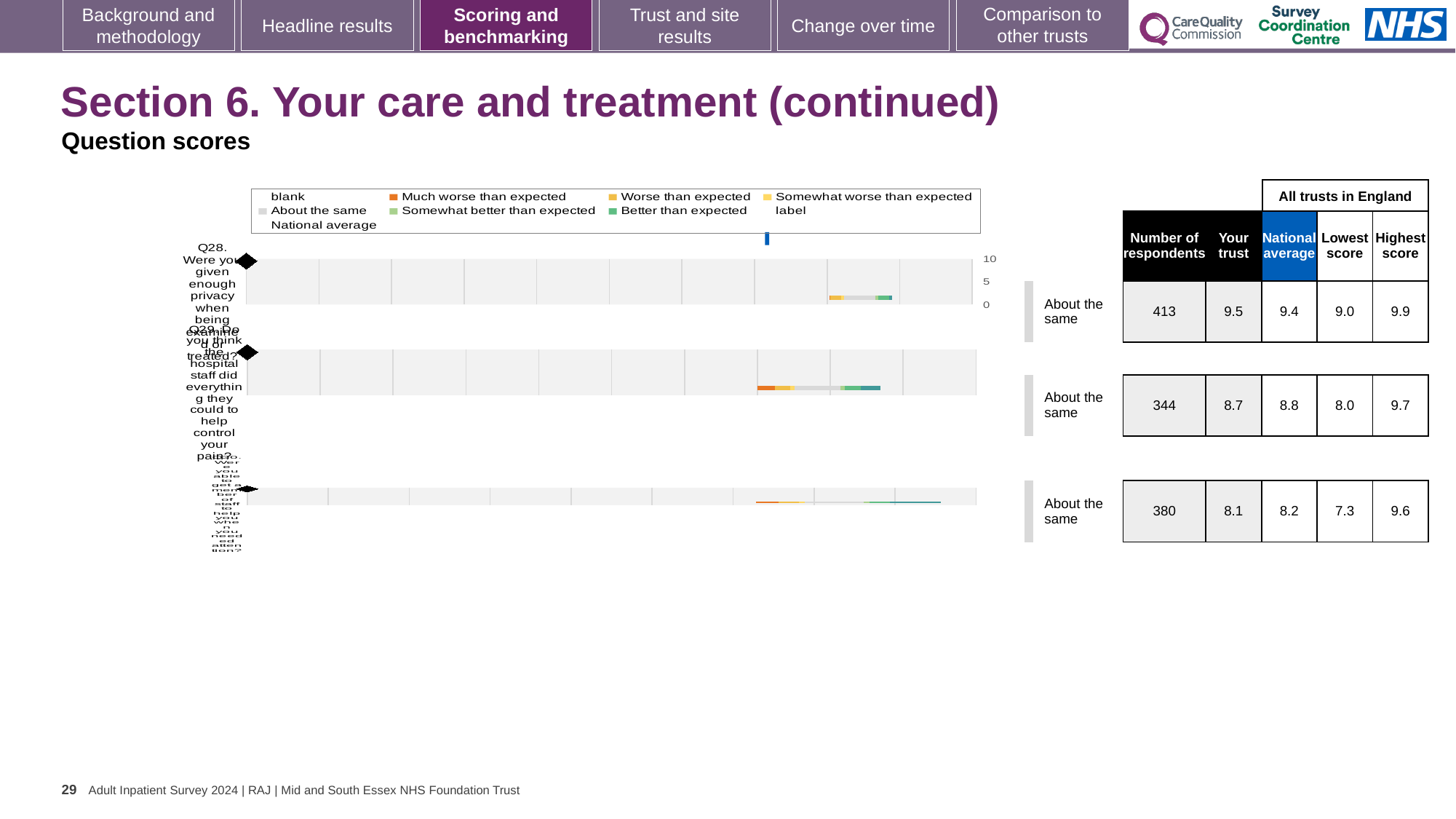
How many respondents answered Q30? 380 Which question has the highest 'Your trust' score? Q28 What is the difference between the 'Your trust' score and the national average for Q28? 0.1 What is the 'Your trust' score for Q28? 9.5 What is the national average score for Q29? 8.8 Which question has the fewest respondents? Q29 What benchmark category is shown for Q30? About the same What kind of chart is shown on the slide? bar chart How many questions (rows) are plotted in the chart? 3 What is the highest score among all trusts in England for Q28? 9.9 For Q29, which is larger: the 'Your trust' score or the national average? National average What is the lowest score among all trusts in England for Q30? 7.3